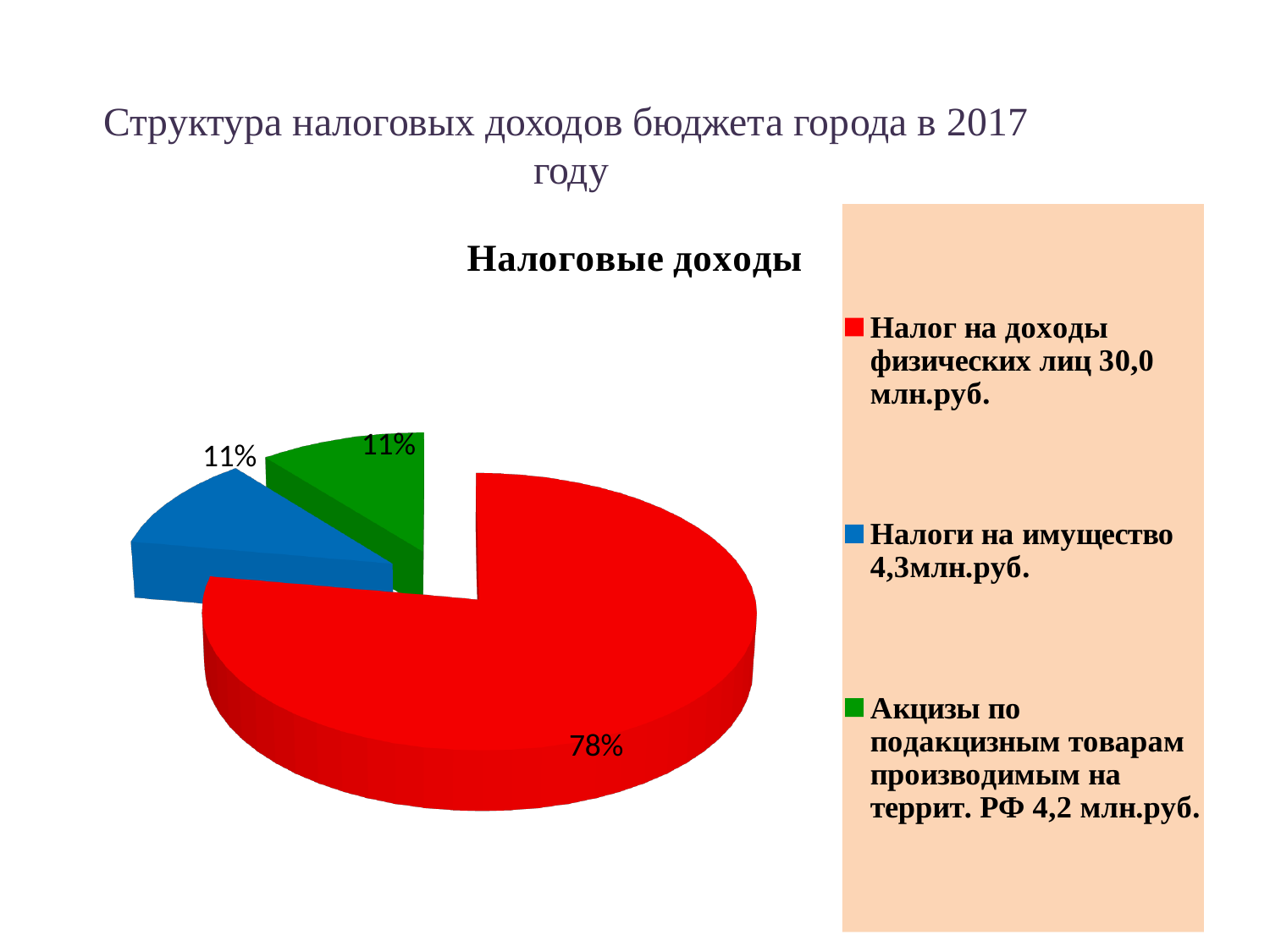
Which category has the largest slice of the pie? Налог на доходы физических лиц What share of the pie is labelled for Налог на доходы физических лиц? 78% Which is larger: the slice for Налог на доходы физических лиц or the slice for Налоги на имущество? Налог на доходы физических лиц What share of the pie is labelled for Акцизы по подакцизным товарам производимым на террит. РФ? 11% By how many percentage points does the Налог на доходы физических лиц slice exceed the Налоги на имущество slice? 67 percentage points How many entries does the legend list? 3 What is the title of the chart? Налоговые доходы What share of the pie is labelled for Налоги на имущество? 11% What amount in млн.руб. does the legend give for Налоги на имущество? 4,3 млн.руб. What colour is the slice for Акцизы по подакцизным товарам производимым на террит. РФ? Green What kind of chart is shown on the slide? Pie chart How many slices does the pie chart have? 3